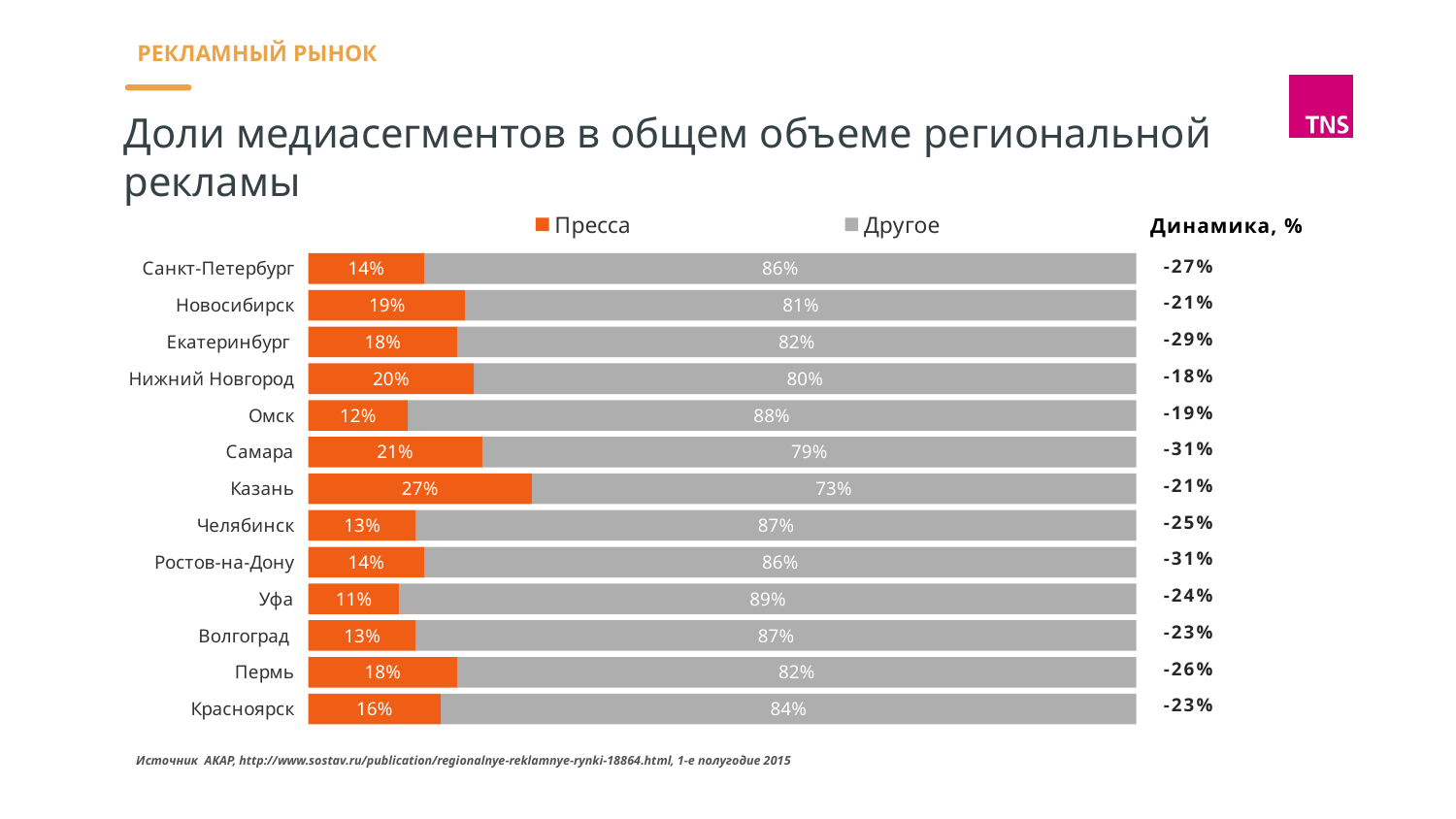
What is the share of Другое for Уфа? 89% Which city has the lowest share of Пресса? Уфа Which is larger: the Пресса share for Самара or for Новосибирск? Самара What is the share of Пресса for Омск? 12% How many cities are shown in the chart? 13 What is the difference between the Пресса share for Казань and for Санкт-Петербург? 13% How many series does the legend list? 2 What is the total of the stacked bar for Пермь? 100% What kind of chart is shown on the slide? Stacked bar chart What is the share of Пресса for Казань? 27% Which colour represents Пресса in the chart? Orange Which city has the highest share of Пресса? Казань